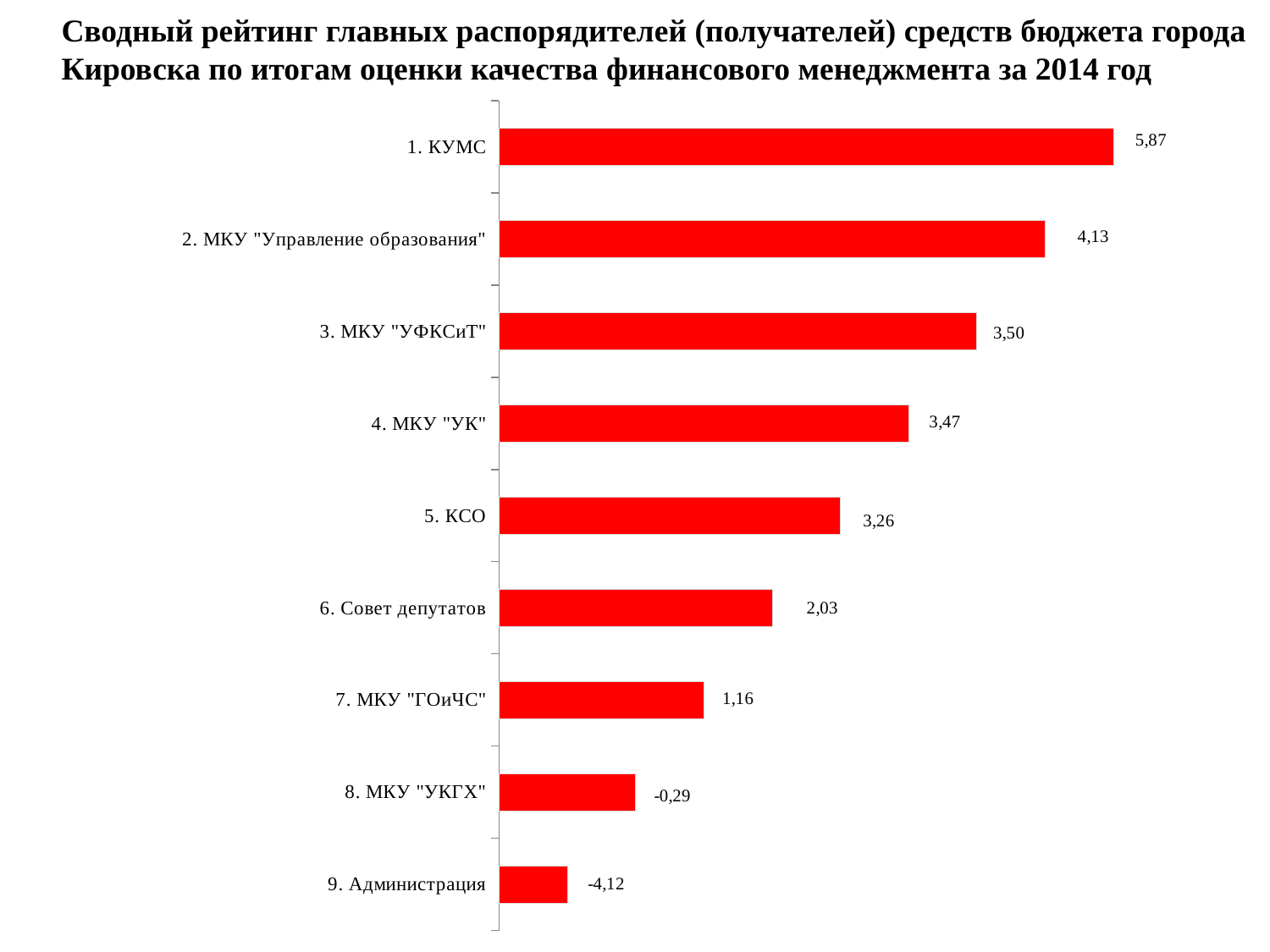
How many categories (organisations) are plotted in the chart? 9 What kind of chart is shown on the slide? bar chart What is the value for 1. КУМС? 5,87 Which category has the highest value? 1. КУМС What colour are the bars in the chart? red What is the value for 8. МКУ "УКГХ"? -0,29 Which category has the lowest value? 9. Администрация Which has the larger value, 6. Совет депутатов or 7. МКУ "ГОиЧС"? 6. Совет депутатов What is the value for 2. МКУ "Управление образования"? 4,13 What is the difference between the values for 1. КУМС and 2. МКУ "Управление образования"? 1,74 What is the value for 5. КСО? 3,26 What is the value for 9. Администрация? -4,12